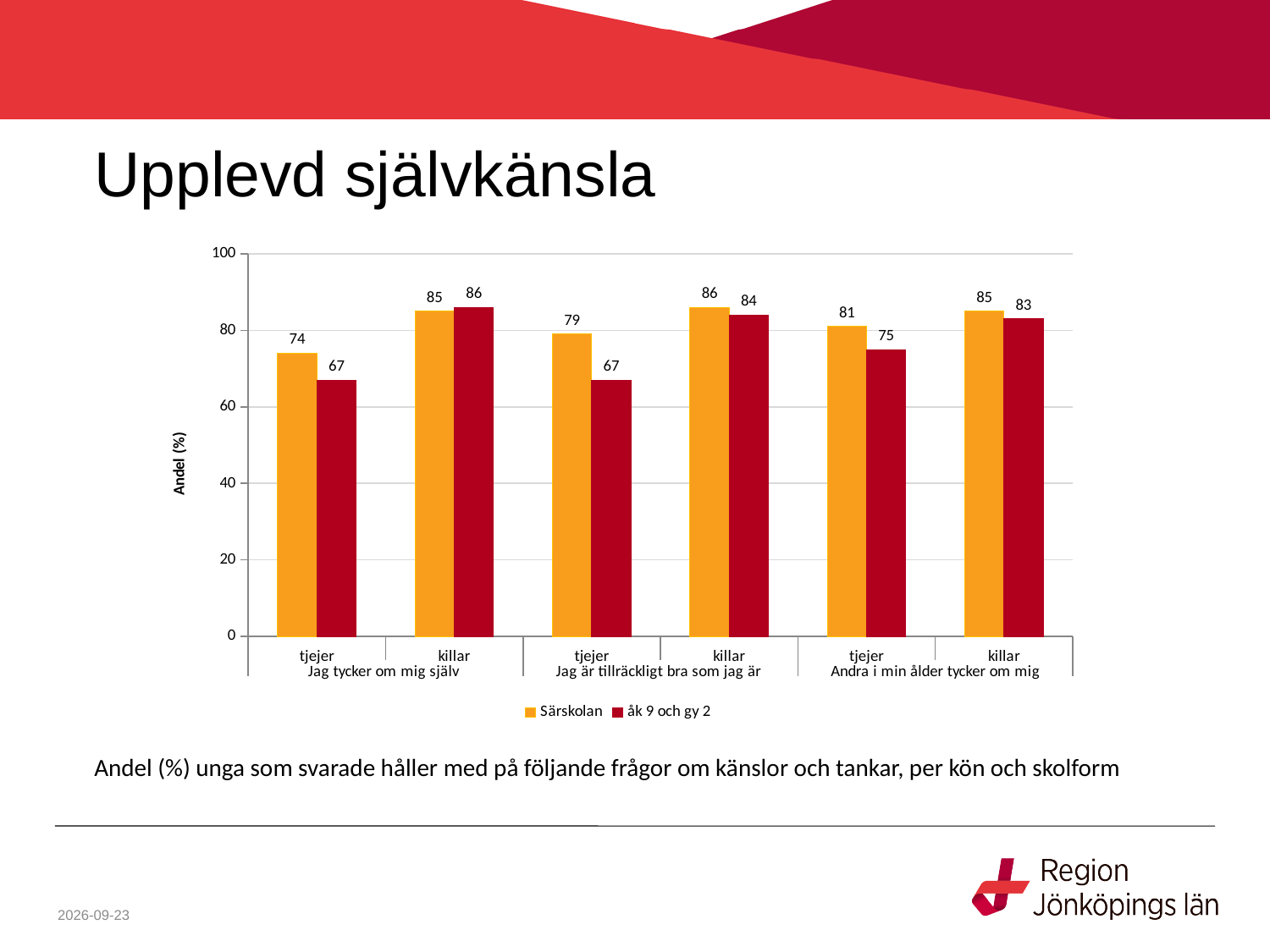
How many series does the legend list? 2 What is the value for åk 9 och gy 2 killar under "Jag är tillräckligt bra som jag är"? 84 Which group has the lowest value in the chart? åk 9 och gy 2 tjejer (67, under "Jag tycker om mig själv" and "Jag är tillräckligt bra som jag är") Which colour represents Särskolan in the chart? orange Which is larger under "Jag tycker om mig själv" for killar: Särskolan or åk 9 och gy 2? åk 9 och gy 2 What is the label of the y axis? Andel (%) What is the value for Särskolan killar under "Andra i min ålder tycker om mig"? 85 Is the value for Särskolan tjejer under "Jag tycker om mig själv" greater or less than 80? less What kind of chart is shown on the slide? bar chart What is the difference between Särskolan tjejer and åk 9 och gy 2 tjejer under "Jag är tillräckligt bra som jag är"? 12 What is the value for åk 9 och gy 2 tjejer under "Andra i min ålder tycker om mig"? 75 What is the value for Särskolan tjejer under "Jag tycker om mig själv"? 74